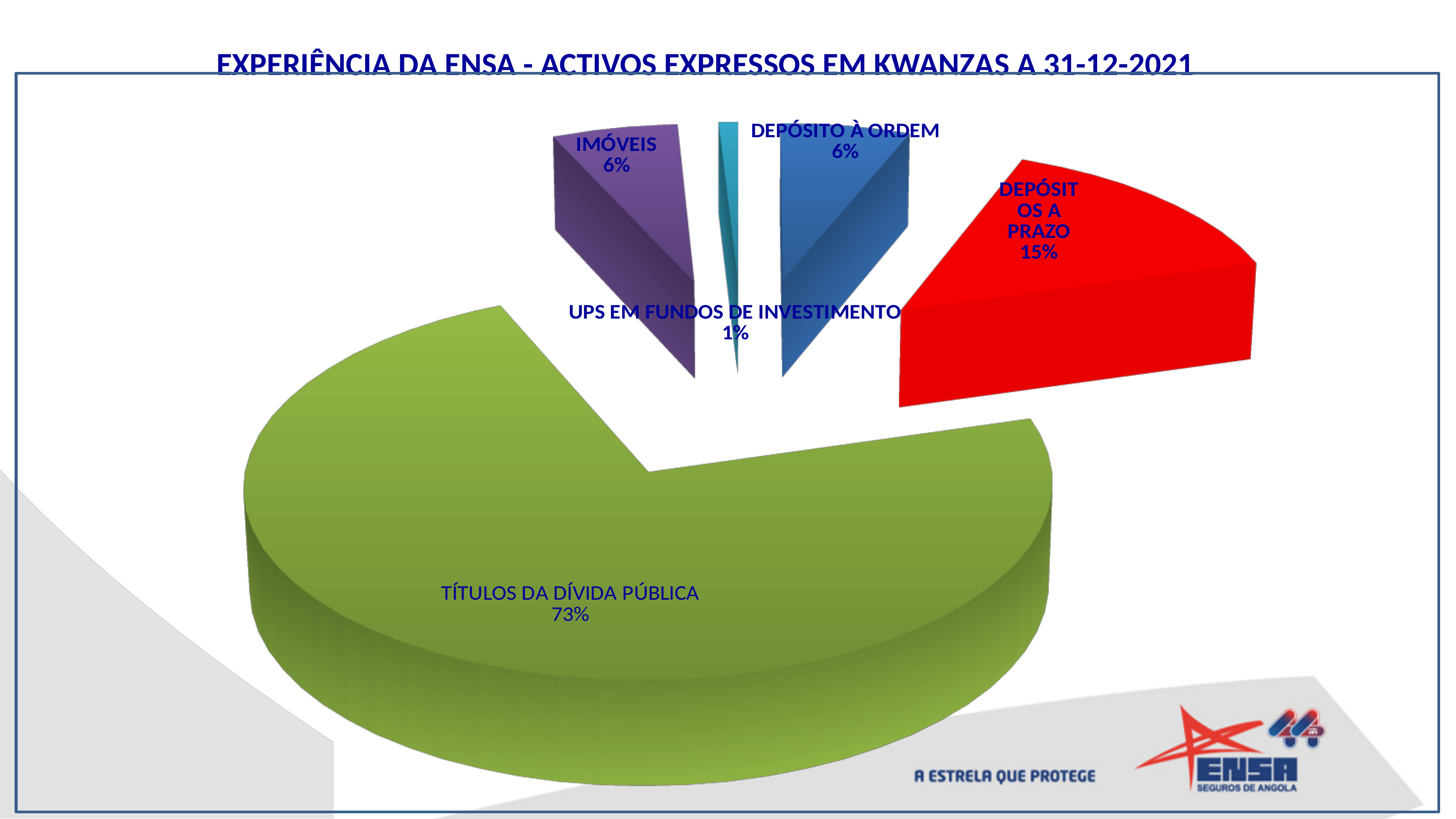
What share of the pie does DEPÓSITOS A PRAZO hold? 15% What is the title of the chart? EXPERIÊNCIA DA ENSA - ACTIVOS EXPRESSOS EM KWANZAS A 31-12-2021 What share of the pie does UPS EM FUNDOS DE INVESTIMENTO hold? 1% Which category has the smallest slice of the pie? UPS EM FUNDOS DE INVESTIMENTO What kind of chart is shown on the slide? Pie chart What share of the pie does IMÓVEIS hold? 6% Which category has the largest slice of the pie? TÍTULOS DA DÍVIDA PÚBLICA Which is larger, DEPÓSITOS A PRAZO or IMÓVEIS? DEPÓSITOS A PRAZO How many categories are shown in the pie chart? 5 What is the difference in percentage points between TÍTULOS DA DÍVIDA PÚBLICA and DEPÓSITOS A PRAZO? 58